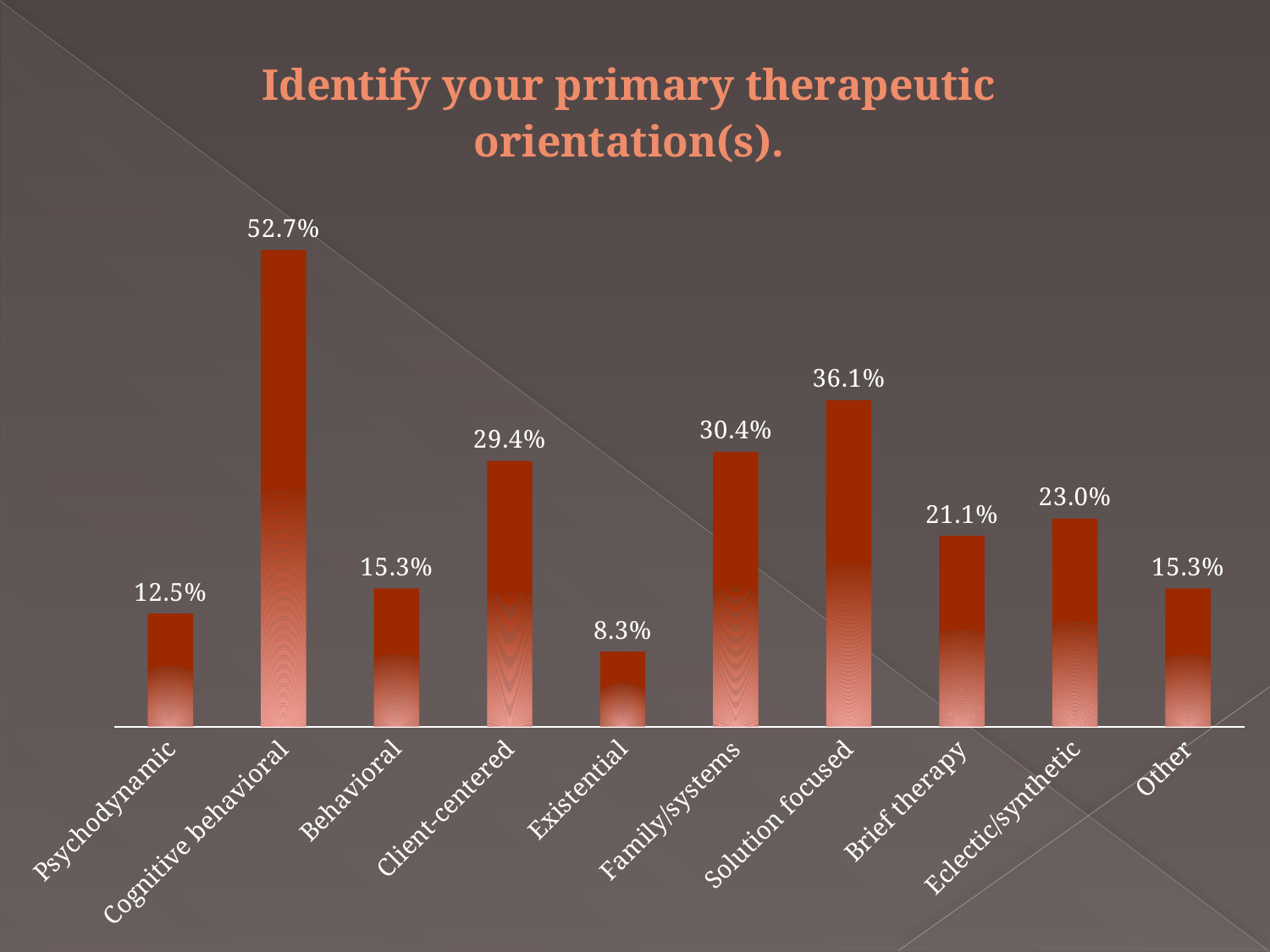
Which has a higher value, Client-centered or Brief therapy? Client-centered What kind of chart is shown on the slide? Bar chart What is the difference in percentage points between Cognitive behavioral and Solution focused? 16.6 What is the value shown for Eclectic/synthetic? 23.0% What percentage of respondents identified Cognitive behavioral as their primary therapeutic orientation? 52.7% How many therapeutic orientation categories are shown on the chart? 10 What is the difference in percentage points between Eclectic/synthetic and Brief therapy? 1.9 Which therapeutic orientation has the lowest percentage? Existential What is the title of the chart? Identify your primary therapeutic orientation(s). Which therapeutic orientation has the highest percentage? Cognitive behavioral What is the value shown for Existential? 8.3% What is the value shown for Solution focused? 36.1%